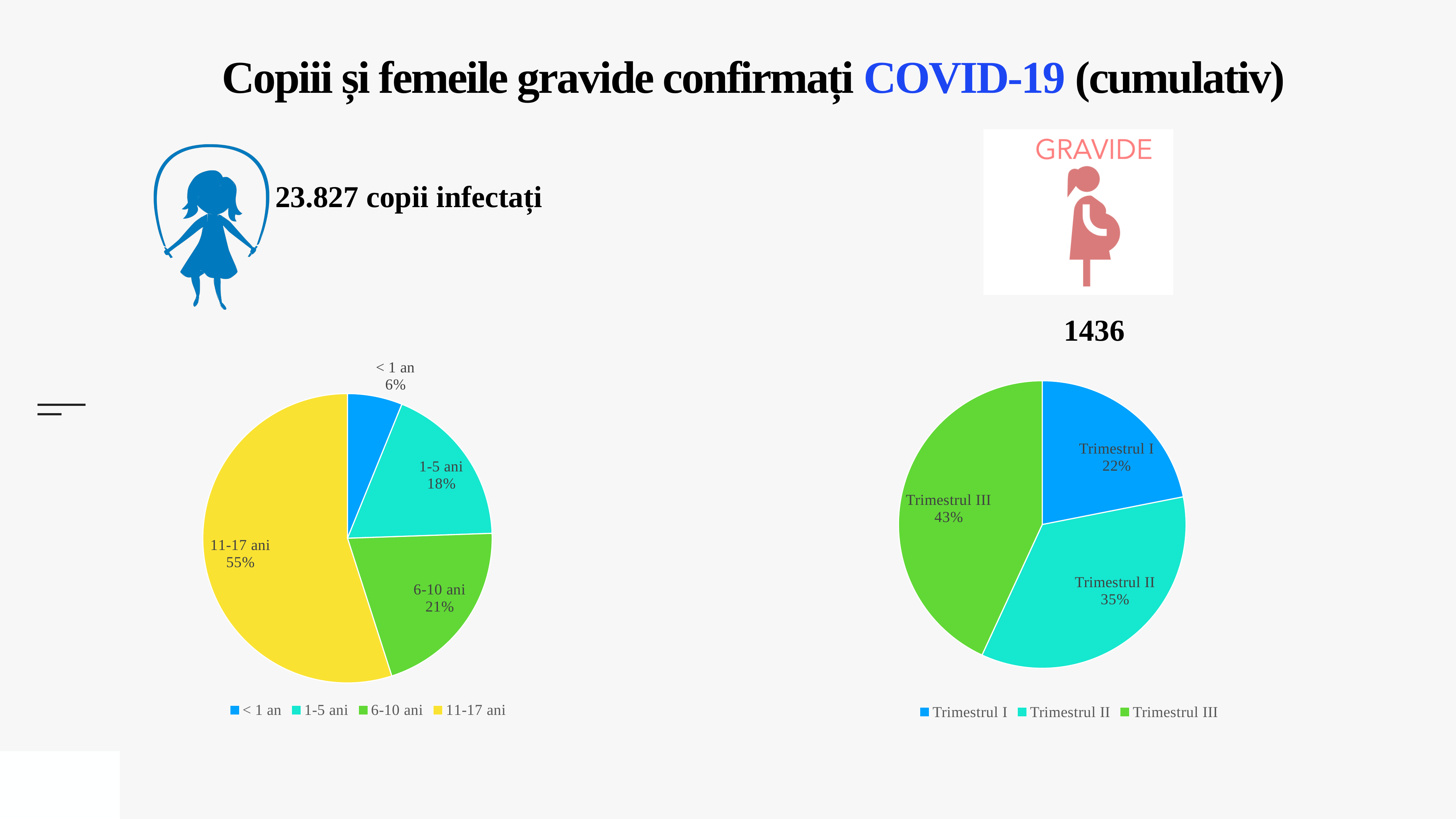
In the left pie chart (children by age group), what share is shown for 11-17 ani? 55% In the left pie chart (children by age group), which age group has the smallest share? < 1 an In the right pie chart (pregnant women by trimester), what share is shown for Trimestrul II? 35% In the right pie chart (pregnant women by trimester), what is the difference between the shares of Trimestrul III and Trimestrul I? 21% What type of chart is the left chart (children by age group)? Pie chart In the right pie chart (pregnant women by trimester), how many entries does the legend list? 3 In the left pie chart (children by age group), which age group has the largest share? 11-17 ani In the left pie chart (children by age group), how many slices does the pie have? 4 In the left pie chart (children by age group), what is the difference between the shares of 6-10 ani and 1-5 ani? 3% In the right pie chart (pregnant women by trimester), which trimester has the largest share? Trimestrul III In the left pie chart (children by age group), what share is shown for < 1 an? 6% In the right pie chart (pregnant women by trimester), which is larger, Trimestrul I or Trimestrul II? Trimestrul II